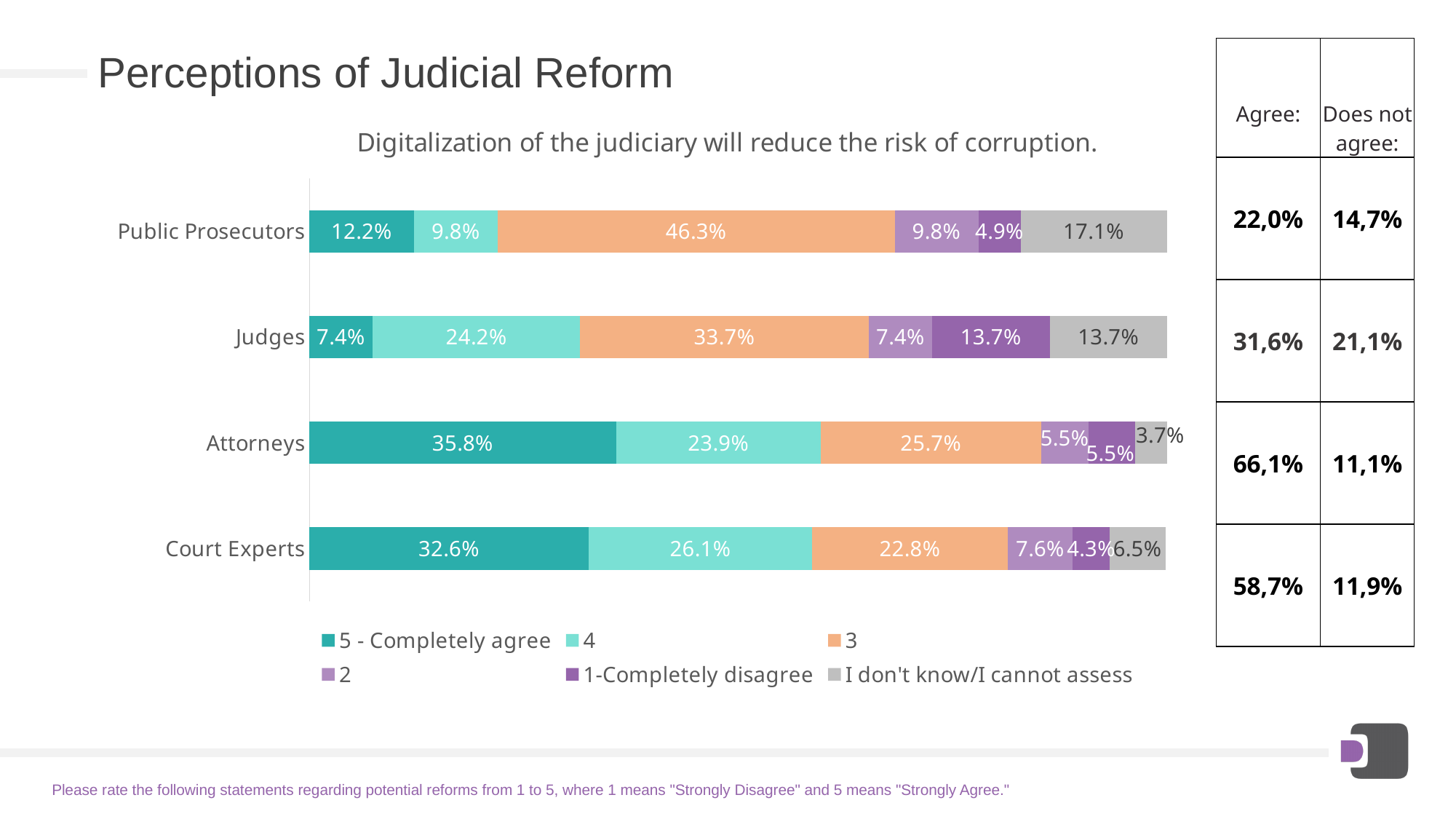
What type of chart is shown on the slide? Stacked bar chart What is the difference in percentage points between the "5 - Completely agree" share for Attorneys and for Court Experts? 3.2 percentage points What percentage of Public Prosecutors chose "3" for the statement that digitalization of the judiciary will reduce the risk of corruption? 46.3% How many respondent groups are shown in the chart? 4 How many series does the chart legend list? 6 Which group has the highest share of "5 - Completely agree" responses? Attorneys Which is larger: the "3" share for Judges or the "3" share for Attorneys? Judges Which group has the lowest share of "5 - Completely agree" responses? Judges What percentage of Court Experts chose "4"? 26.1% What percentage of Judges chose "1-Completely disagree"? 13.7% What statement is the chart about, as given in the chart title? Digitalization of the judiciary will reduce the risk of corruption. Which group has the highest share of "I don't know/I cannot assess" responses? Public Prosecutors